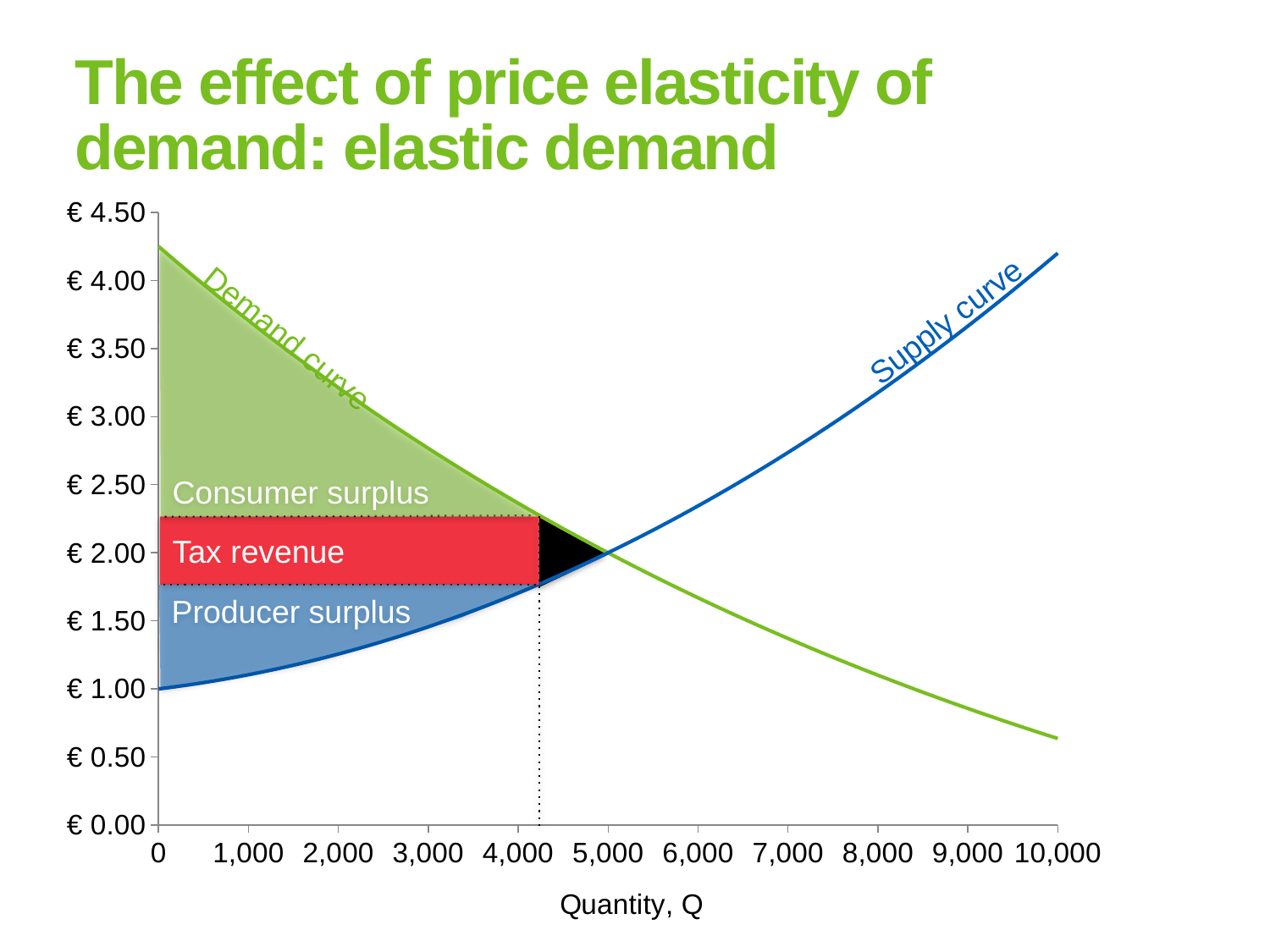
What kind of chart is shown on the slide? line chart Does the demand curve rise or fall as quantity increases? fall Is the price on the demand curve at a quantity of 10,000 greater or less than € 1.00? less How many curves are labelled on the chart? 2 What is the price on the supply curve at a quantity of 0? € 1.00 What is the label of the x axis? Quantity, Q At a quantity of 8,000, which curve shows the higher price, the demand curve or the supply curve? Supply curve Is the quantity at which the demand and supply curves intersect greater or less than 6,000? less At a quantity of 2,000, which curve shows the higher price, the demand curve or the supply curve? Demand curve Does the supply curve rise or fall as quantity increases? rise Is the price on the demand curve at a quantity of 0 greater or less than € 4.00? greater What is the label of the red shaded area? Tax revenue